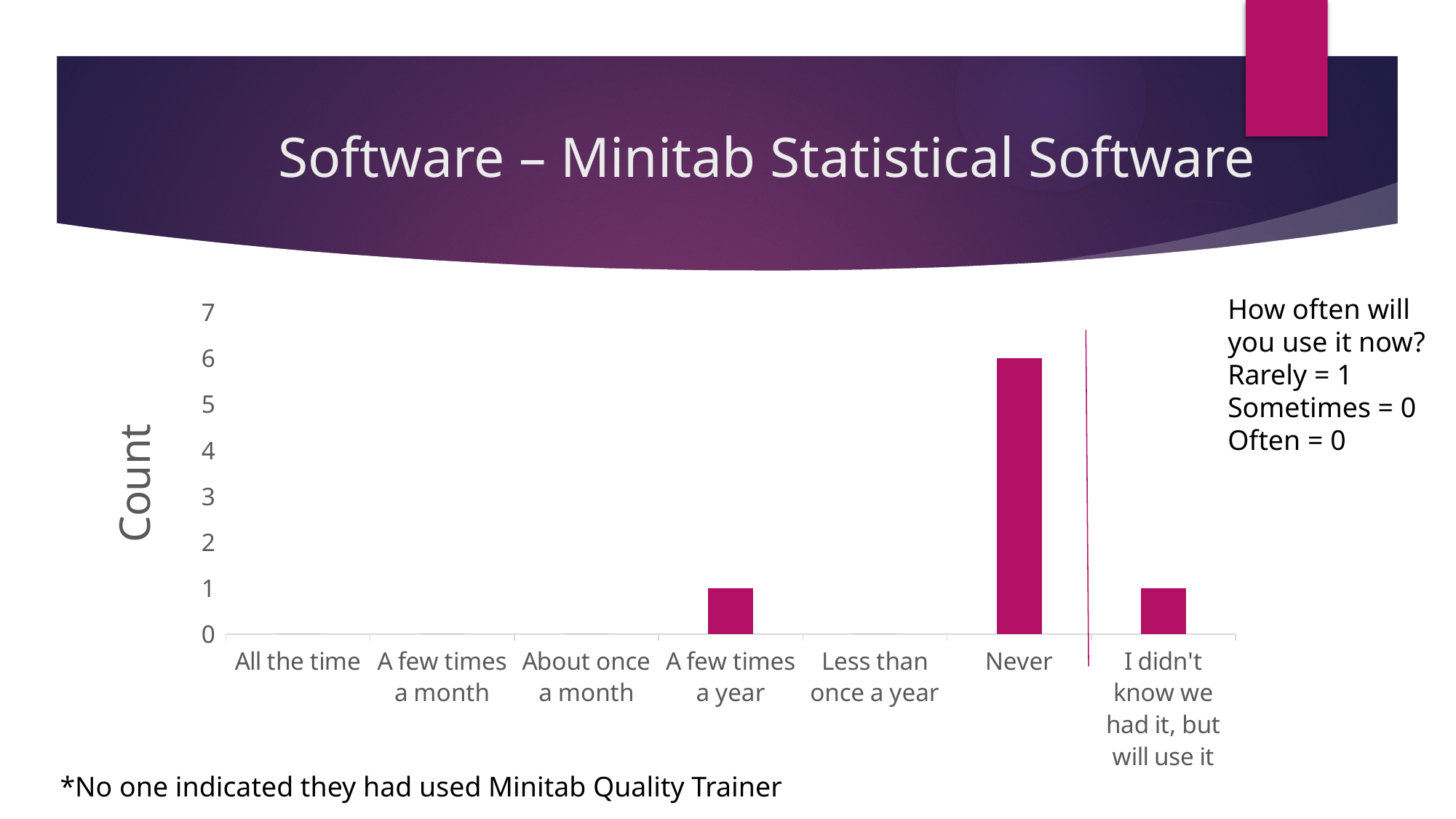
How many categories are shown on the x axis of the chart? 7 What is the count for the 'Never' category? 6 What is the count for 'A few times a year'? 1 What is the count for 'I didn't know we had it, but will use it'? 1 What is the count for 'All the time'? 0 Is the count for 'Never' greater or less than 5? greater Which is larger, the count for 'Never' or the count for 'Less than once a year'? Never What is the difference between the count for 'Never' and the count for 'A few times a year'? 5 What kind of chart is shown on the slide? bar chart Which category has the highest count? Never What is the label on the vertical axis of the chart? Count What is the highest value shown on the vertical axis? 7